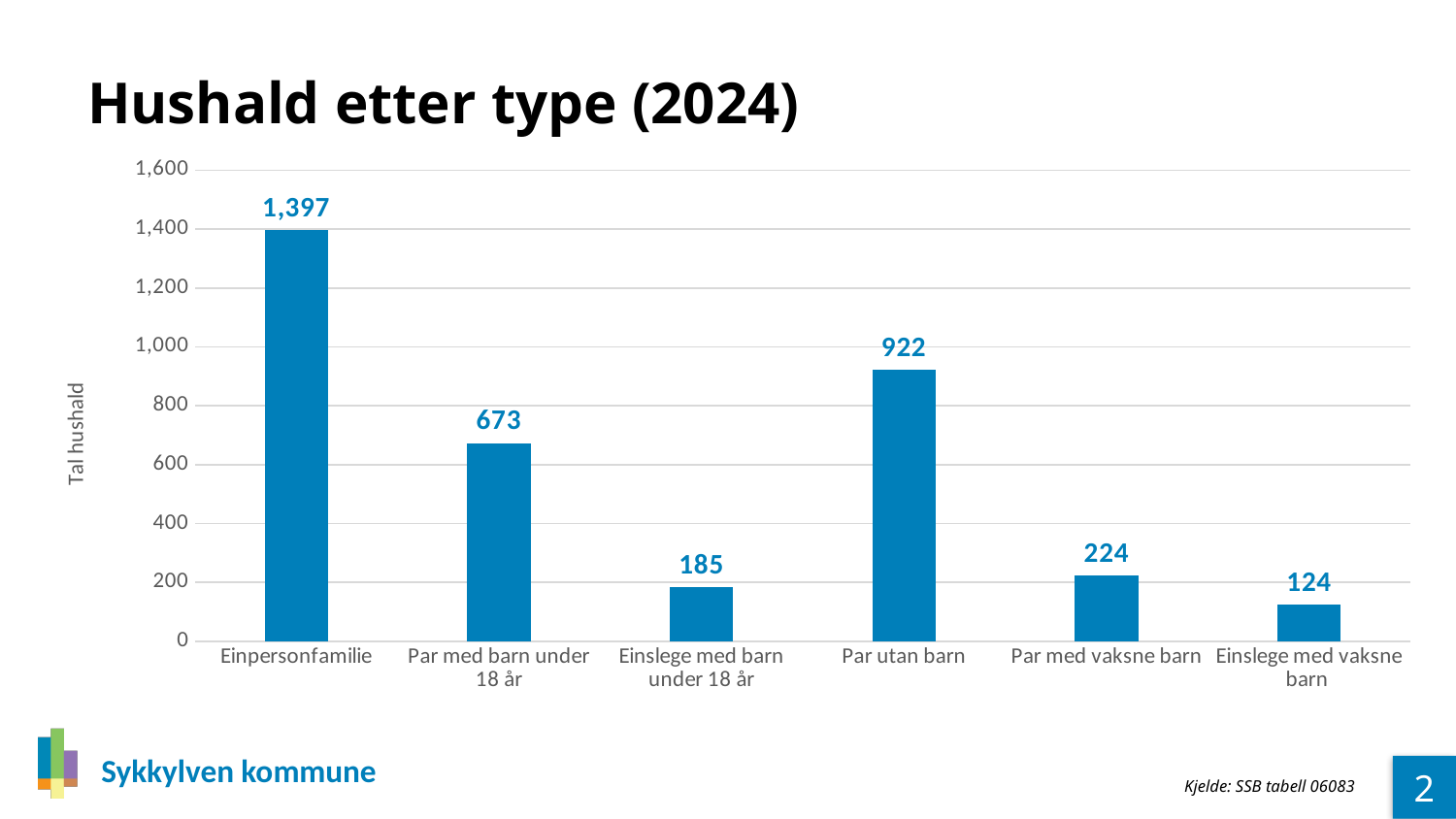
What is the value for Par utan barn? 922 What is the title of the chart? Hushald etter type (2024) What kind of chart is shown on the slide? bar chart Which household type has the highest number of households? Einpersonfamilie What is the difference between Par med vaksne barn and Einslege med barn under 18 år? 39 Is the value for Par med barn under 18 år greater or less than 600? greater How many household types are shown in the chart? 6 Which household type has the lowest number of households? Einslege med vaksne barn What is the value for Einslege med vaksne barn? 124 What is the value for Einpersonfamilie? 1,397 What is the difference between Einpersonfamilie and Par utan barn? 475 Which is larger, Par med barn under 18 år or Par utan barn? Par utan barn